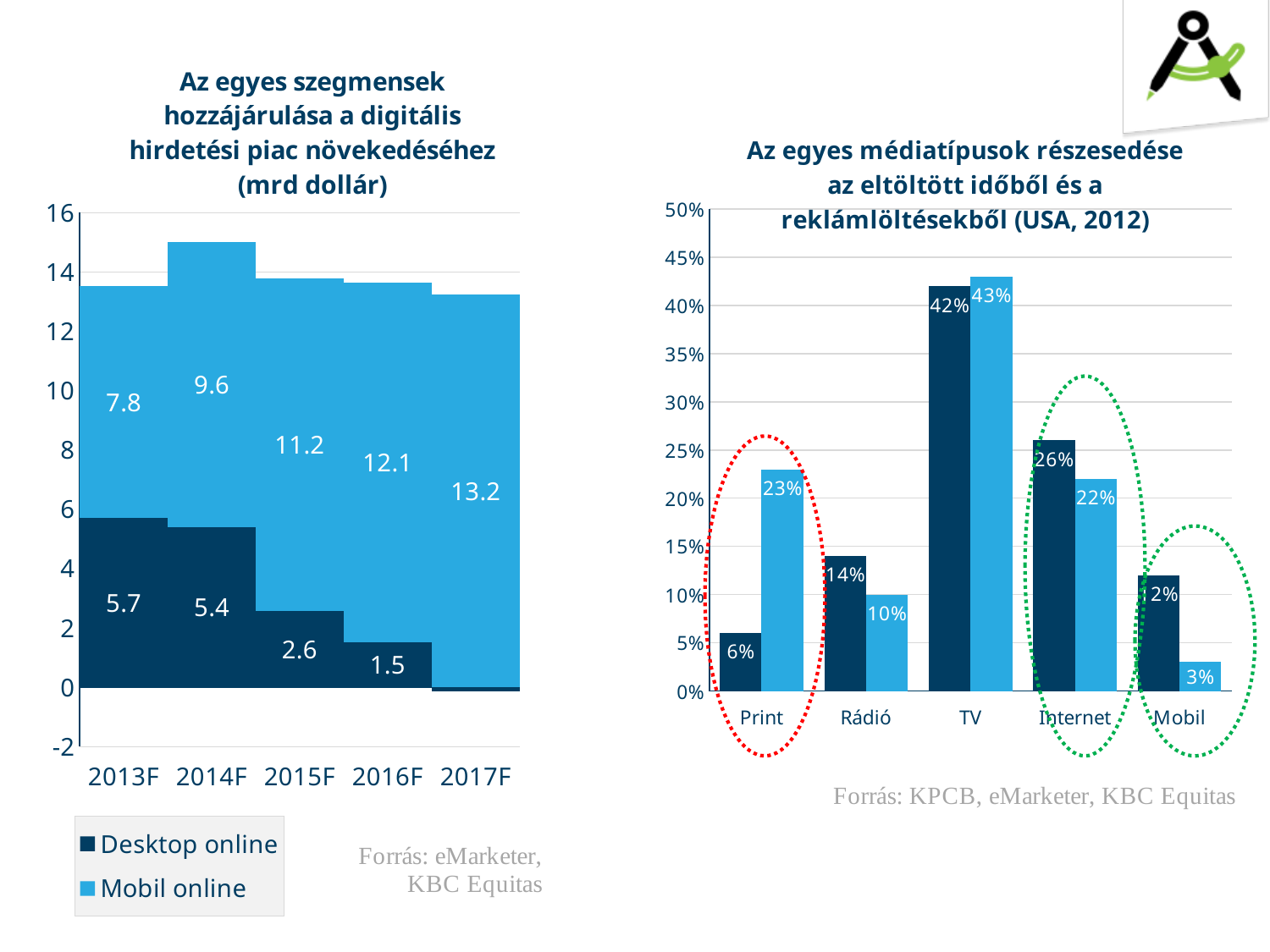
In the left chart (Az egyes szegmensek hozzájárulása...), what is the difference between the Mobil online values for 2017F and 2013F? 5.4 What kind of chart is the right chart (Az egyes médiatípusok részesedése...)? bar chart In the right chart (Az egyes médiatípusok részesedése...), which category has the lowest light blue bar? Mobil How many categories are shown on the x axis of the right chart (Az egyes médiatípusok részesedése...)? 5 In the left chart (Az egyes szegmensek hozzájárulása...), do the Desktop online values rise or fall from 2013F to 2016F? fall How many series does the legend of the left chart list? 2 In the left chart (Az egyes szegmensek hozzájárulása...), which year has the highest Mobil online value? 2017F In the right chart (Az egyes médiatípusok részesedése...), which is larger for Internet: the dark blue bar or the light blue bar? the dark blue bar In the left chart (Az egyes szegmensek hozzájárulása...), what is the Desktop online value for 2013F? 5.7 In the left chart (Az egyes szegmensek hozzájárulása...), what is the combined total of Desktop online and Mobil online for 2014F? 15.0 In the left chart (Az egyes szegmensek hozzájárulása...), what is the Mobil online value for 2015F? 11.2 In the right chart (Az egyes médiatípusok részesedése...), what is the value of the light blue bar for Print? 23%